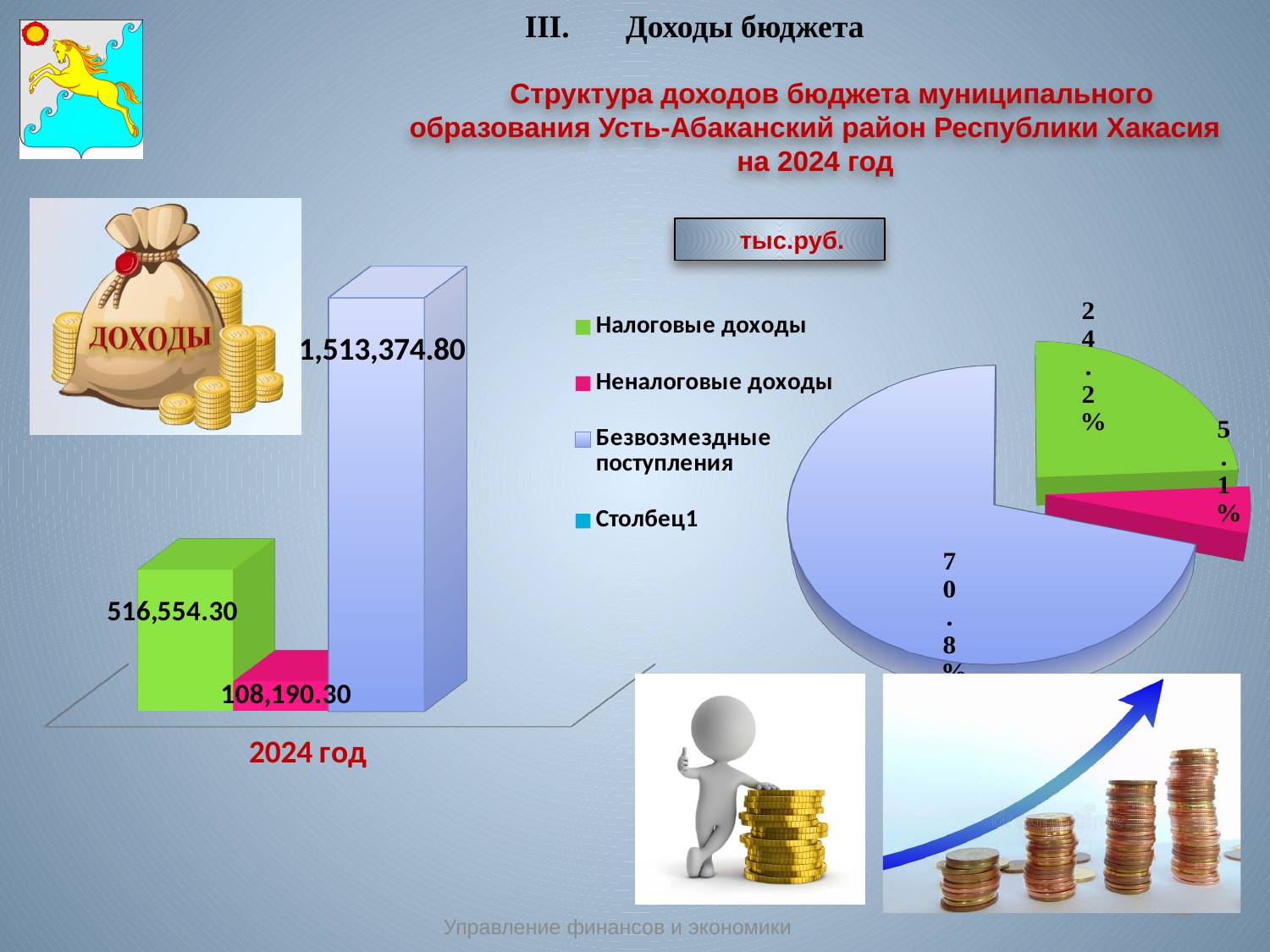
On the bar chart, what is the difference between Налоговые доходы and Неналоговые доходы? 408,364.00 On the bar chart, what is the value for Налоговые доходы in 2024 год? 516,554.30 On the bar chart, what is the value for Неналоговые доходы in 2024 год? 108,190.30 On the bar chart, which is larger: Налоговые доходы or Безвозмездные поступления? Безвозмездные поступления On the bar chart, which series has the highest value? Безвозмездные поступления What kind of chart is shown on the right side of the slide? Pie chart What kind of chart is shown on the left side of the slide? Bar chart On the pie chart, what share is shown for the pink slice (Неналоговые доходы)? 5.1% On the bar chart, what is the value for Безвозмездные поступления in 2024 год? 1,513,374.80 How many entries does the legend list? 4 On the pie chart, what share is shown for the green slice (Налоговые доходы)? 24.2% On the bar chart, which series has the lowest value? Неналоговые доходы